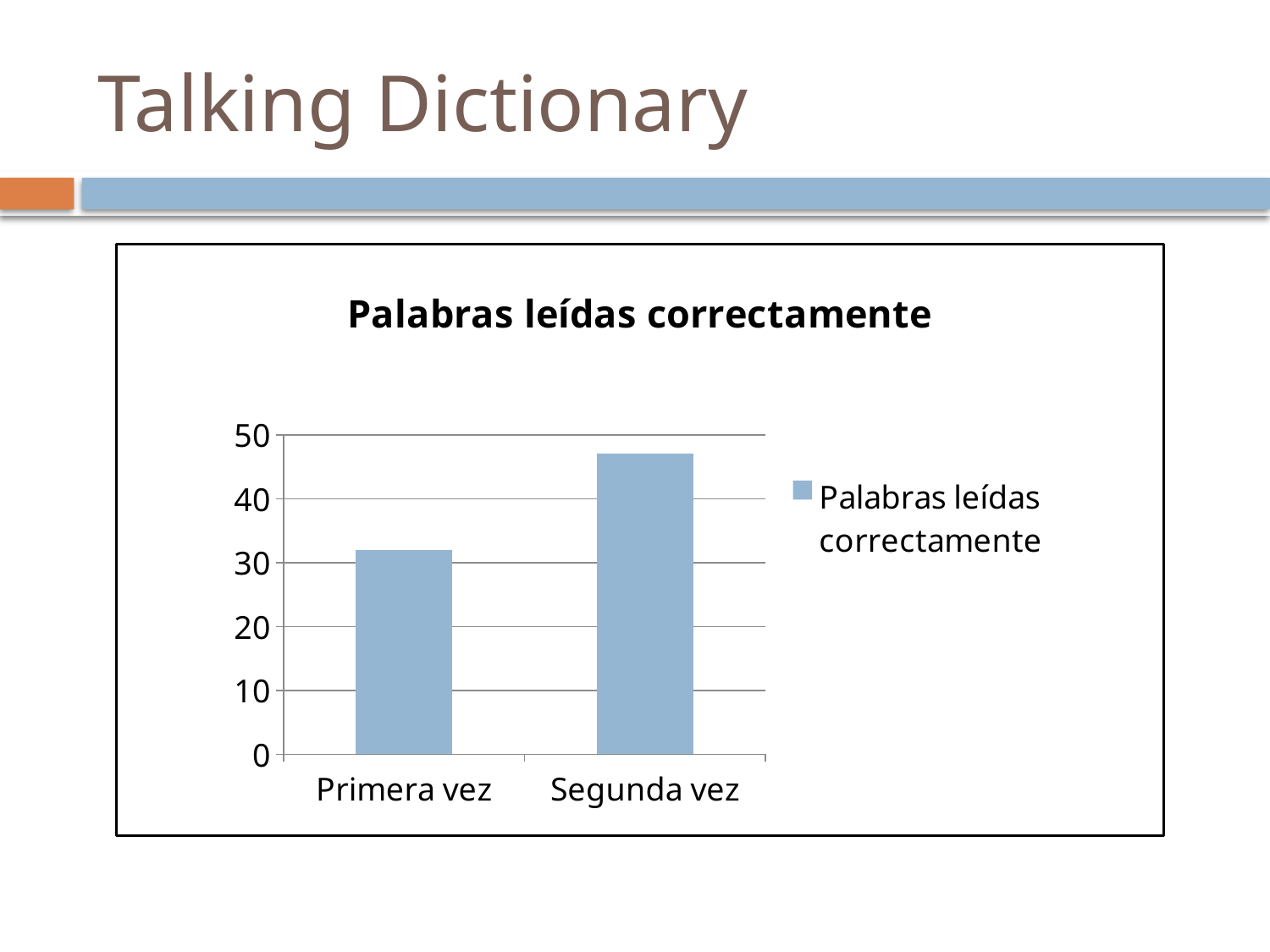
How many series does the legend list? 1 What is the title of the chart? Palabras leídas correctamente What is the name of the series listed in the legend? Palabras leídas correctamente Is the value for Segunda vez greater or less than 50? less Which category has the lowest value? Primera vez Which is larger, the value for Primera vez or the value for Segunda vez? Segunda vez Is the value for Segunda vez greater or less than 40? greater Is the value for Primera vez greater or less than 40? less What kind of chart is shown on the slide? bar chart How many categories are shown on the x axis of the chart? 2 Which category has the highest value? Segunda vez Do the values rise or fall from Primera vez to Segunda vez? rise